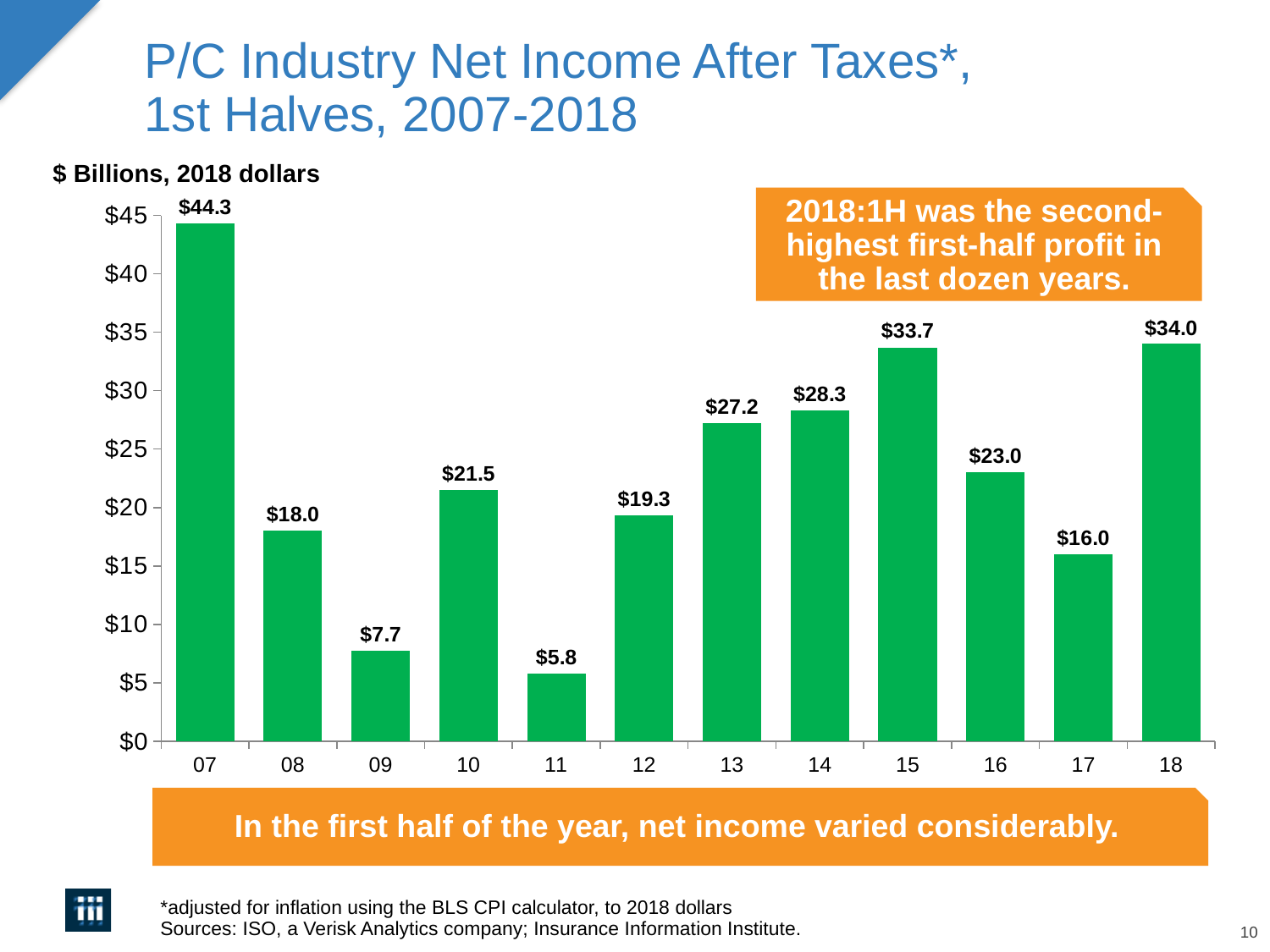
Do the values rise or fall from 2016 to 2017? fall What is the P/C industry net income after taxes for the first half of 2007? $44.3 Which is larger, the value for 2010 or the value for 2012? 2010 How many years are shown on the x axis? 12 Which year has the lowest first-half net income? 11 What unit is stated above the chart? $ Billions, 2018 dollars What is the difference between the 2015 and 2014 first-half values? $5.4 What is the value shown for the first half of 2018? $34.0 What is the value shown for the first half of 2011? $5.8 What is the difference between the 2018 and 2017 first-half values? $18.0 Which year has the highest first-half net income? 07 What kind of chart is this? bar chart